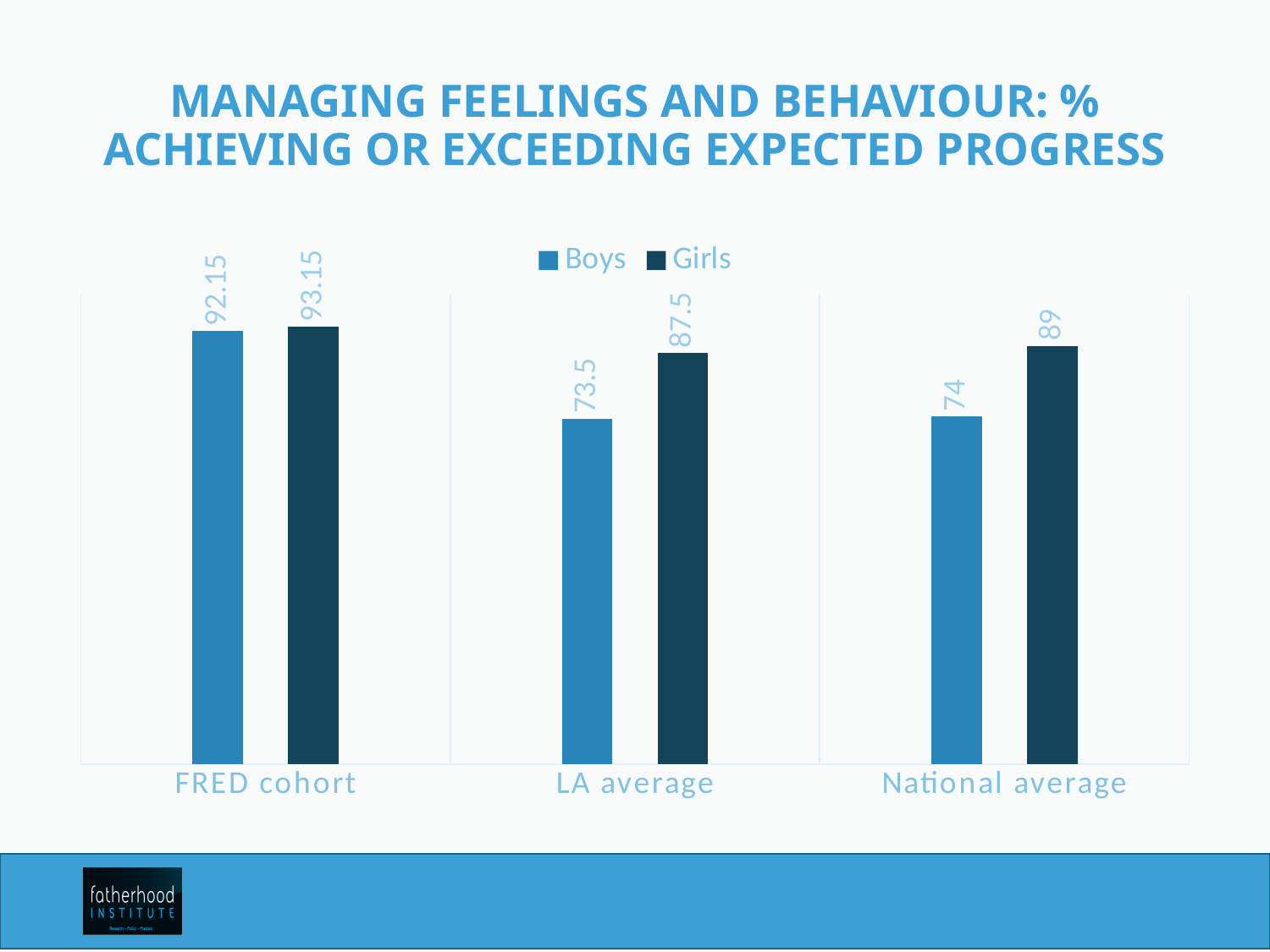
What is the difference between the Girls and Boys values in the National average? 15 What is the value for Boys in the National average? 74 What are the two series named in the legend? Boys and Girls How many series does the legend list? 2 What is the value for Girls in the LA average? 87.5 How many categories are shown on the x axis? 3 What kind of chart is shown on the slide? Bar chart What is the value for Boys in the FRED cohort? 92.15 Which category has the highest value for Girls? FRED cohort Which category has the lowest value for Boys? LA average Which is larger, the Boys value for the FRED cohort or the Boys value for the National average? FRED cohort What is the difference between the Girls and Boys values in the LA average? 14